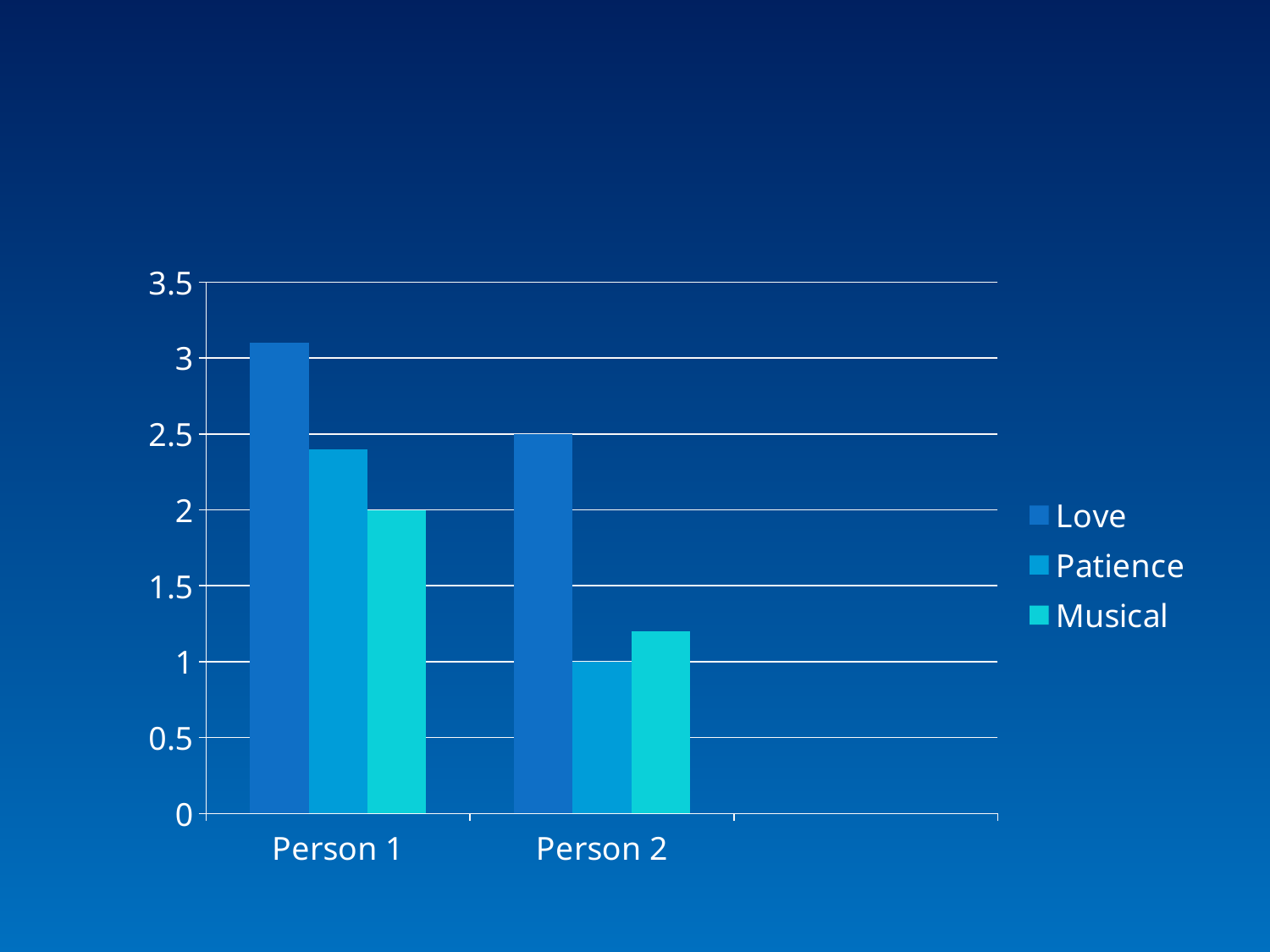
How many series does the legend list? 3 What is the Musical value for Person 1? 2 What is the difference between the Love and Patience values for Person 2? 1.5 Is the Love value for Person 1 greater or less than 3? greater What is the Love value for Person 2? 2.5 How many categories are shown on the x axis? 2 Which series has the highest value for Person 2? Love What type of chart is shown on the slide? bar chart What is the Patience value for Person 2? 1 Which series has the lowest value for Person 1? Musical Is the Musical value for Person 2 greater or less than 1.5? less Is the Patience value for Person 1 greater or less than 2.5? less